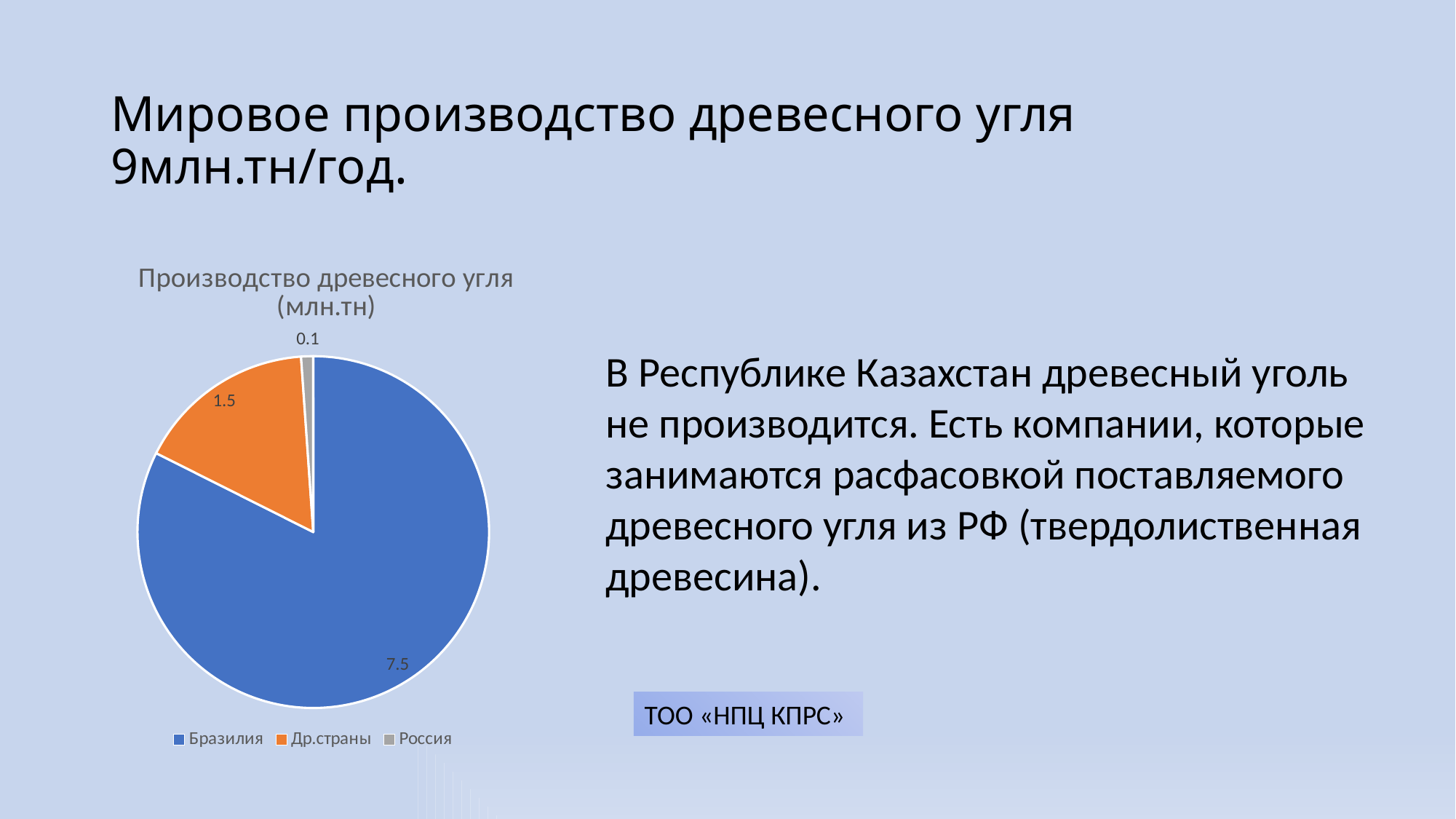
Which category has the smallest slice in the pie chart? Россия Which is larger, the value for Др.страны or the value for Россия? Др.страны What is the value for Бразилия in the pie chart? 7.5 What is the title of the chart? Производство древесного угля (млн.тн) What kind of chart is shown on the slide? Pie chart Which category has the largest slice in the pie chart? Бразилия Which colour represents Др.страны in the pie chart? Orange What is the difference between the values for Др.страны and Россия? 1.4 How many categories does the pie chart show? 3 What is the value for Др.страны in the pie chart? 1.5 What is the value for Россия in the pie chart? 0.1 What is the difference between the values for Бразилия and Др.страны? 6